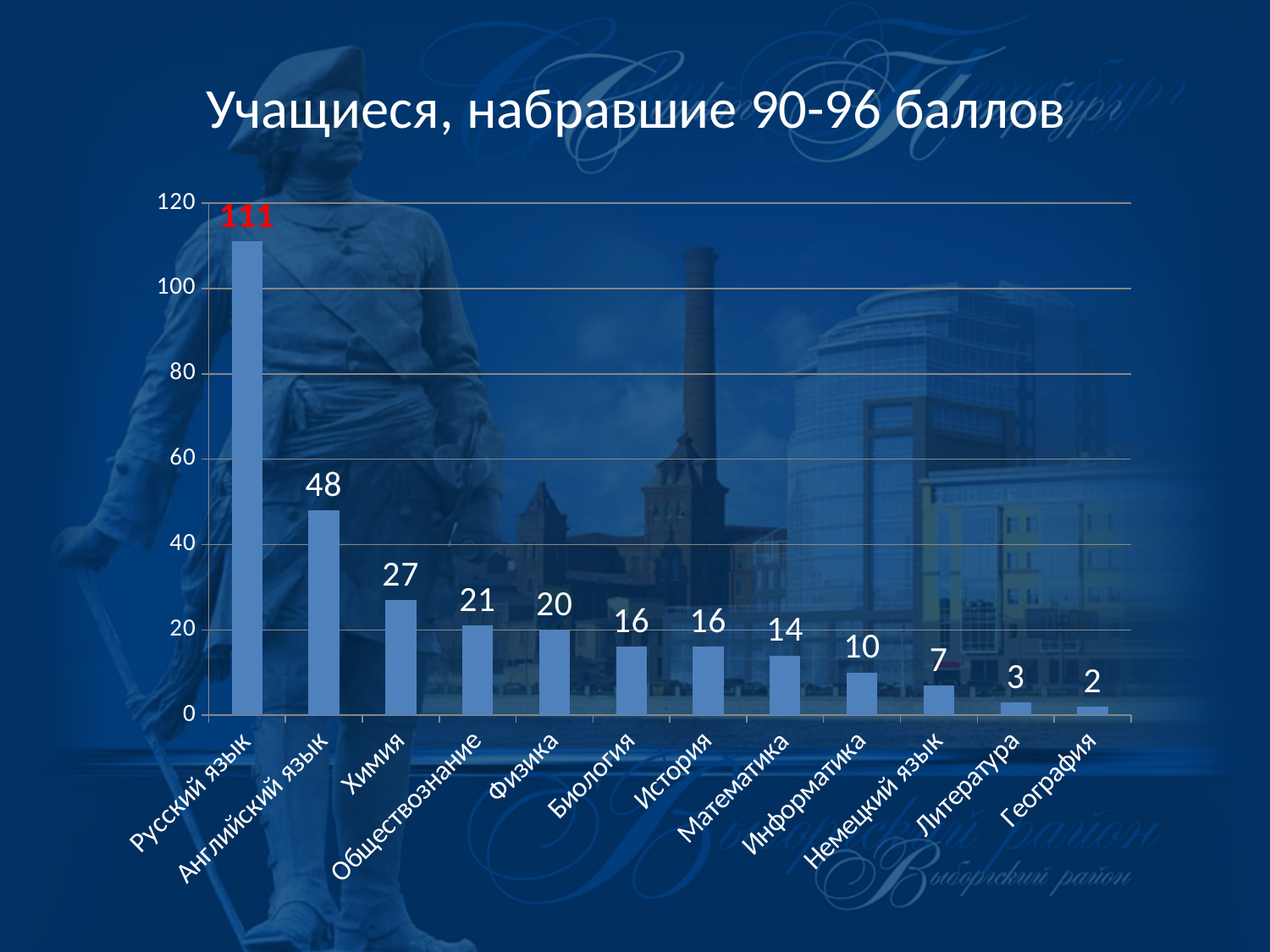
Which category has the highest value? Русский язык How many categories are shown on the x axis? 12 What is the value for Информатика? 10 What is the value for Русский язык? 111 Which is larger, the value for Обществознание or the value for Физика? Обществознание What is the value for Химия? 27 What is the title of the chart? Учащиеся, набравшие 90-96 баллов Which category has the lowest value? География Do the values rise or fall from left to right along the x axis? fall What is the difference between the values for Русский язык and Английский язык? 63 What kind of chart is shown on the slide? bar chart Is the value for Английский язык greater or less than 40? greater